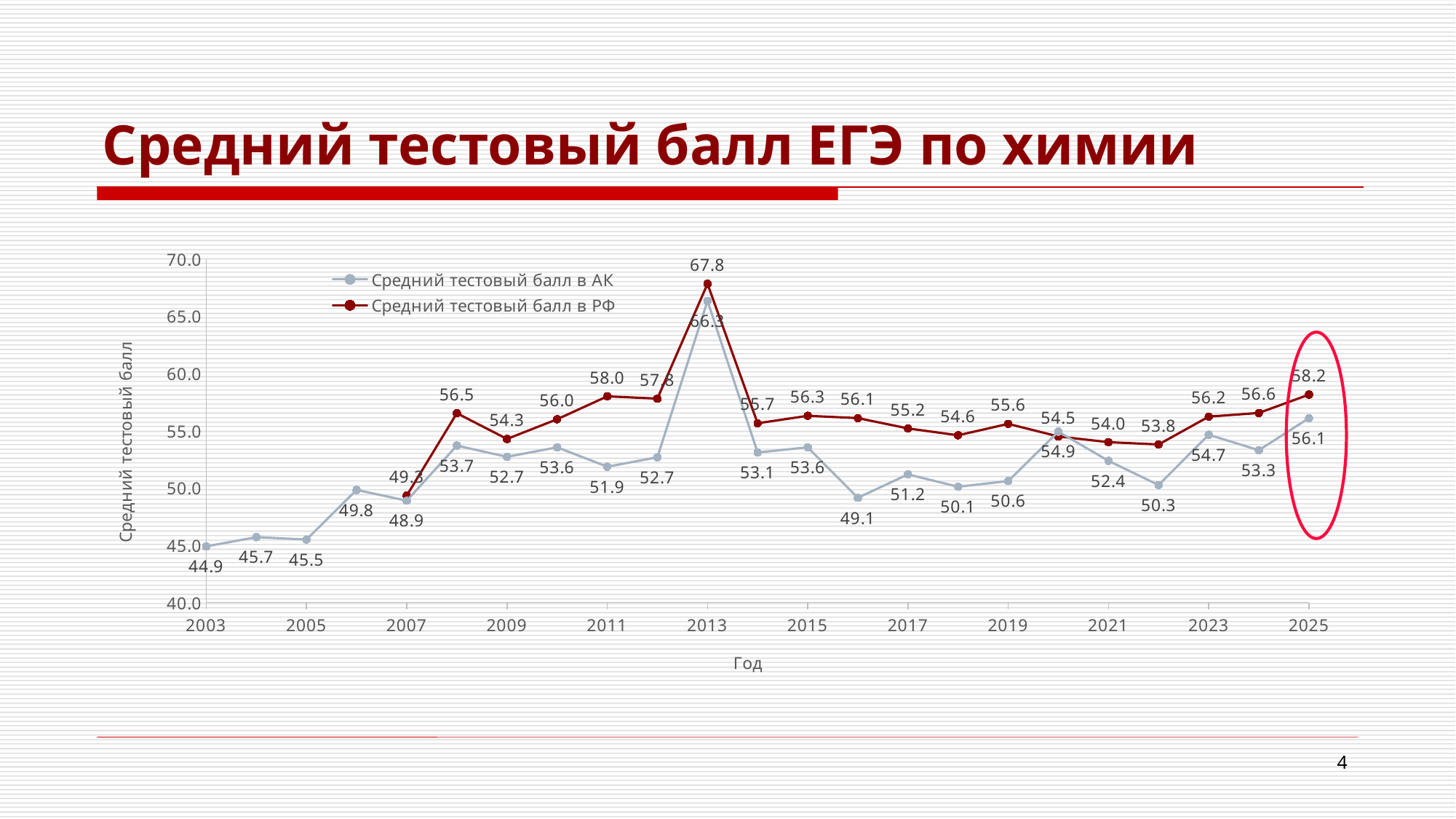
In which year does 'Средний тестовый балл в РФ' reach its highest value? 2013 In which year is 'Средний тестовый балл в АК' at its lowest? 2003 How many series does the legend list? 2 Is the value of 'Средний тестовый балл в АК' in 2016 greater or less than 50.0? less What is the difference between 'Средний тестовый балл в РФ' and 'Средний тестовый балл в АК' in 2025? 2.1 What is the label of the y axis? Средний тестовый балл Which series has the higher value in 2020, 'Средний тестовый балл в АК' or 'Средний тестовый балл в РФ'? Средний тестовый балл в АК What type of chart is shown on the slide? line chart What is the value of 'Средний тестовый балл в АК' in 2013? 66.3 What is the value of 'Средний тестовый балл в АК' in 2003? 44.9 What is the value of 'Средний тестовый балл в РФ' in 2025? 58.2 How many years are plotted on the x axis for 'Средний тестовый балл в АК'? 23